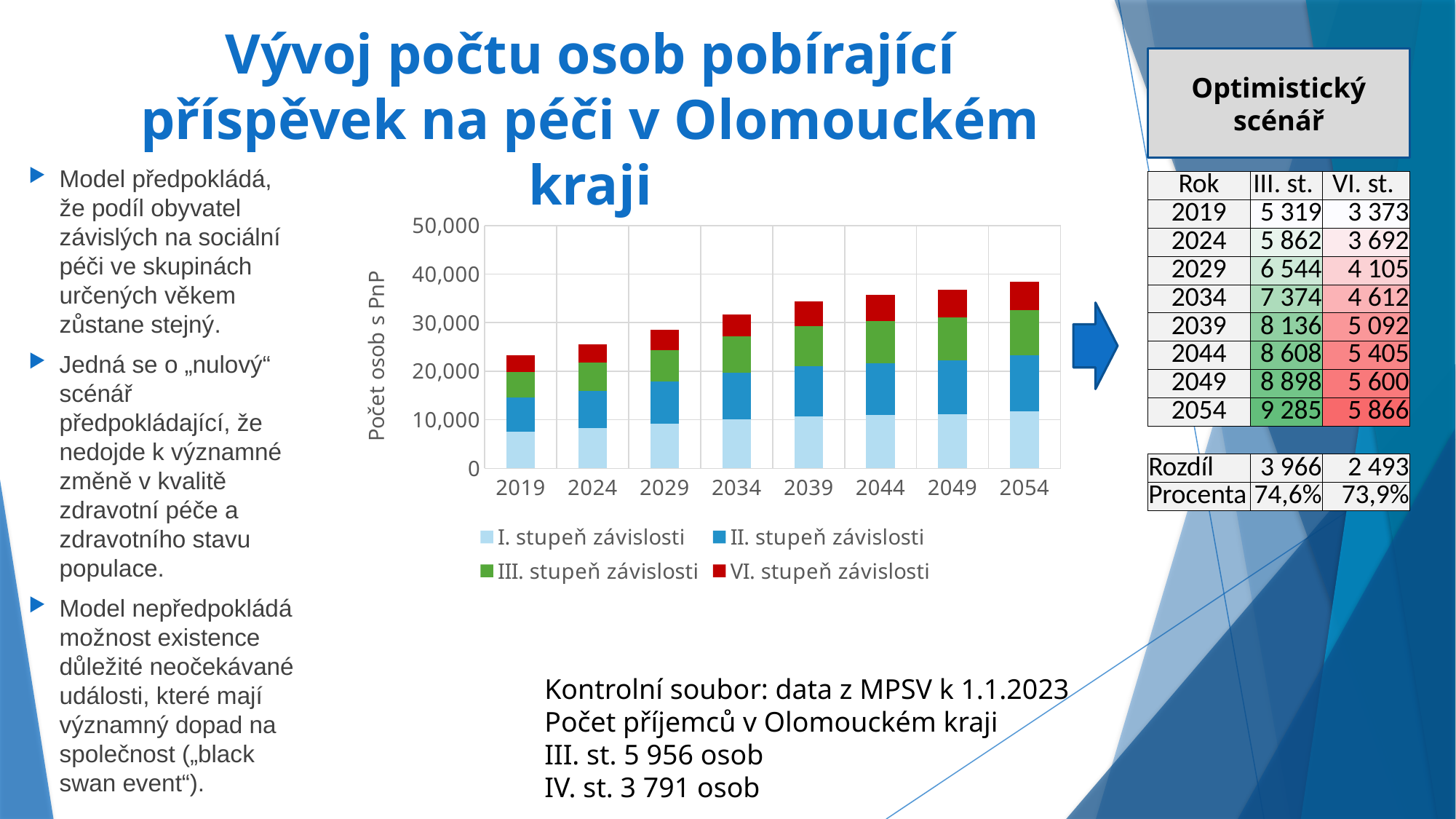
Which year has the highest total number of persons in the chart? 2054 Which year has the lowest total number of persons in the chart? 2019 Is the total value for 2054 greater or less than 30,000? greater Is the total value for 2054 greater or less than 40,000? less Is the total value for 2029 greater or less than 30,000? less What kind of chart is shown on the slide? Stacked bar chart Which series is shown in red in the chart legend? VI. stupeň závislosti How many years (categories) are shown on the x axis of the chart? 8 What is the label of the vertical axis of the chart? Počet osob s PnP Do the total bar heights rise or fall from 2019 to 2054? Rise How many series does the chart legend list? 4